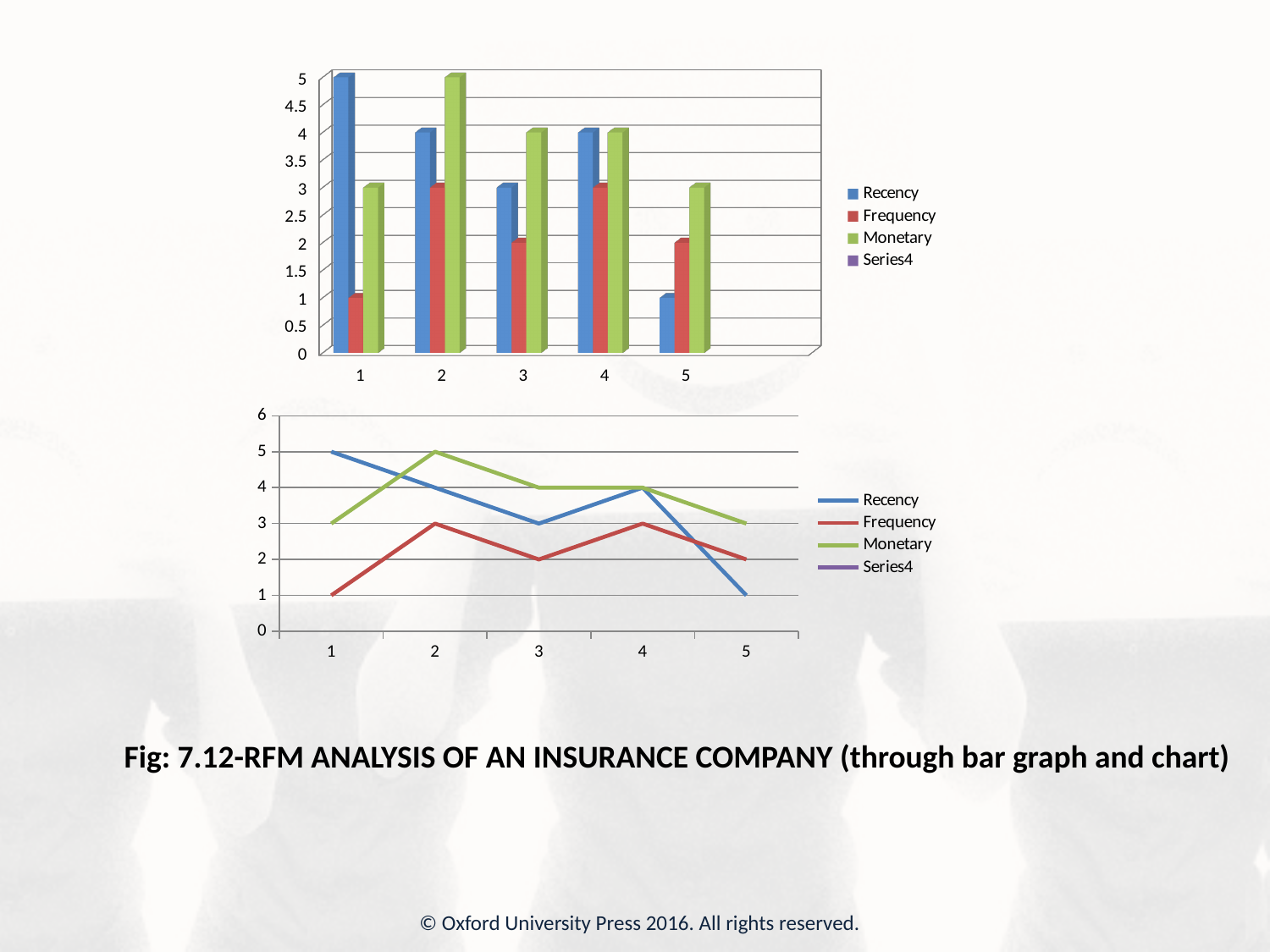
How many categories are shown on the x axis of the top bar chart? 5 What kind of chart is the top chart on the slide? bar chart In the bottom line chart, what is the Frequency value at category 3? 2 In the bottom line chart, what is the Monetary value at category 2? 5 In the top bar chart, what is the Recency value for category 1? 5 In the bottom line chart, what is the difference between the Recency and Frequency values at category 1? 4 In the top bar chart, which is larger at category 5: Frequency or Monetary? Monetary In the bottom line chart, which category has the highest Monetary value? 2 How many series does the legend of the bottom line chart list? 4 In the top bar chart, which colour represents the Monetary series? green In the top bar chart, which category has the lowest Recency value? 5 In the bottom line chart, does the Recency line rise or fall from category 4 to category 5? fall